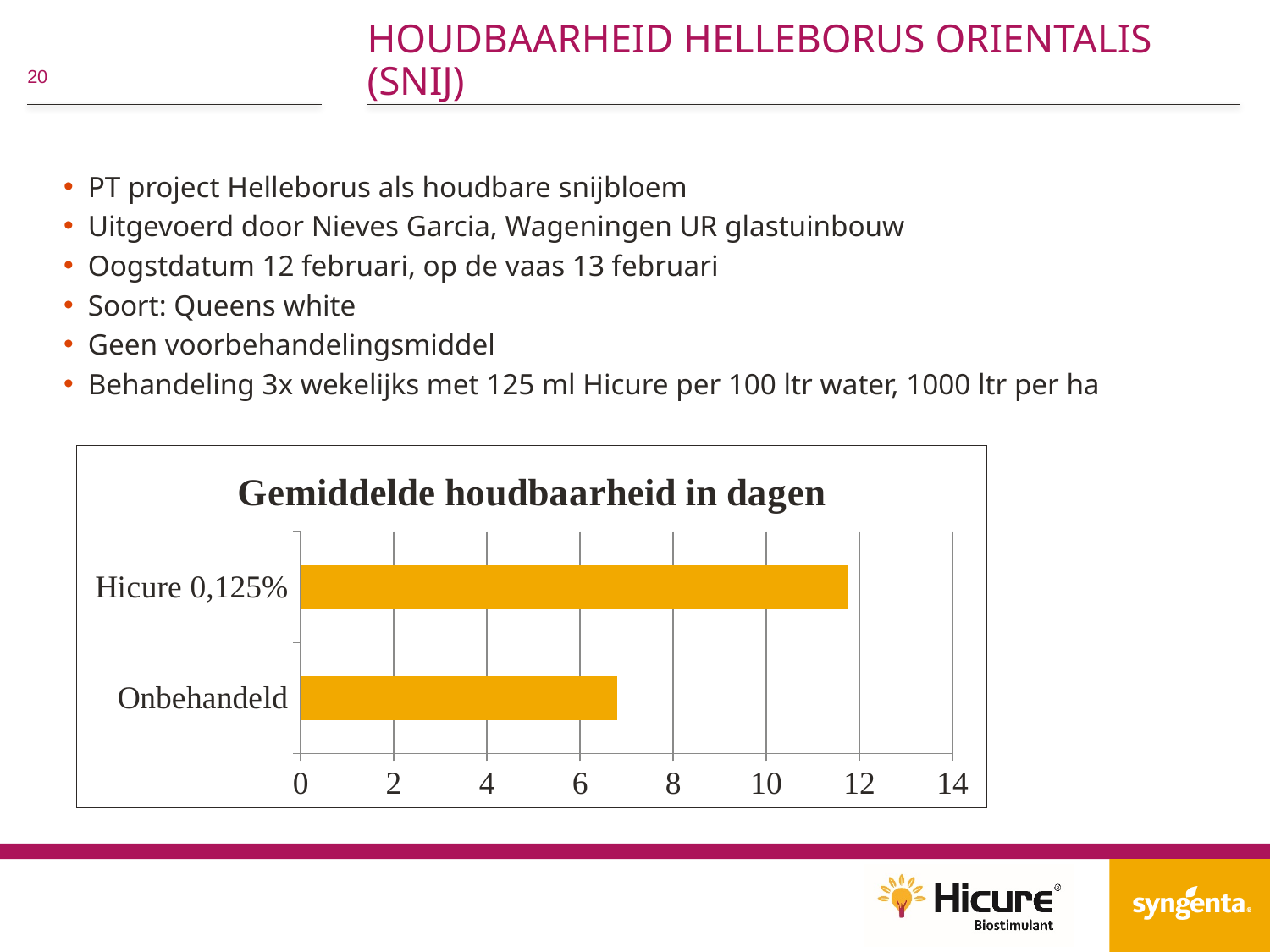
Which category has the lowest value in the chart? Onbehandeld What is the title of the chart? Gemiddelde houdbaarheid in dagen What is the highest value shown on the x axis of the chart? 14 How many categories are plotted in the chart? 2 Which is larger, the value for Hicure 0,125% or the value for Onbehandeld? Hicure 0,125% What kind of chart is shown on the slide? bar chart Is the value for Onbehandeld greater or less than 6? greater Is the value for Hicure 0,125% greater or less than 10? greater Which category has the highest value in the chart? Hicure 0,125% Is the value for Onbehandeld greater or less than 8? less